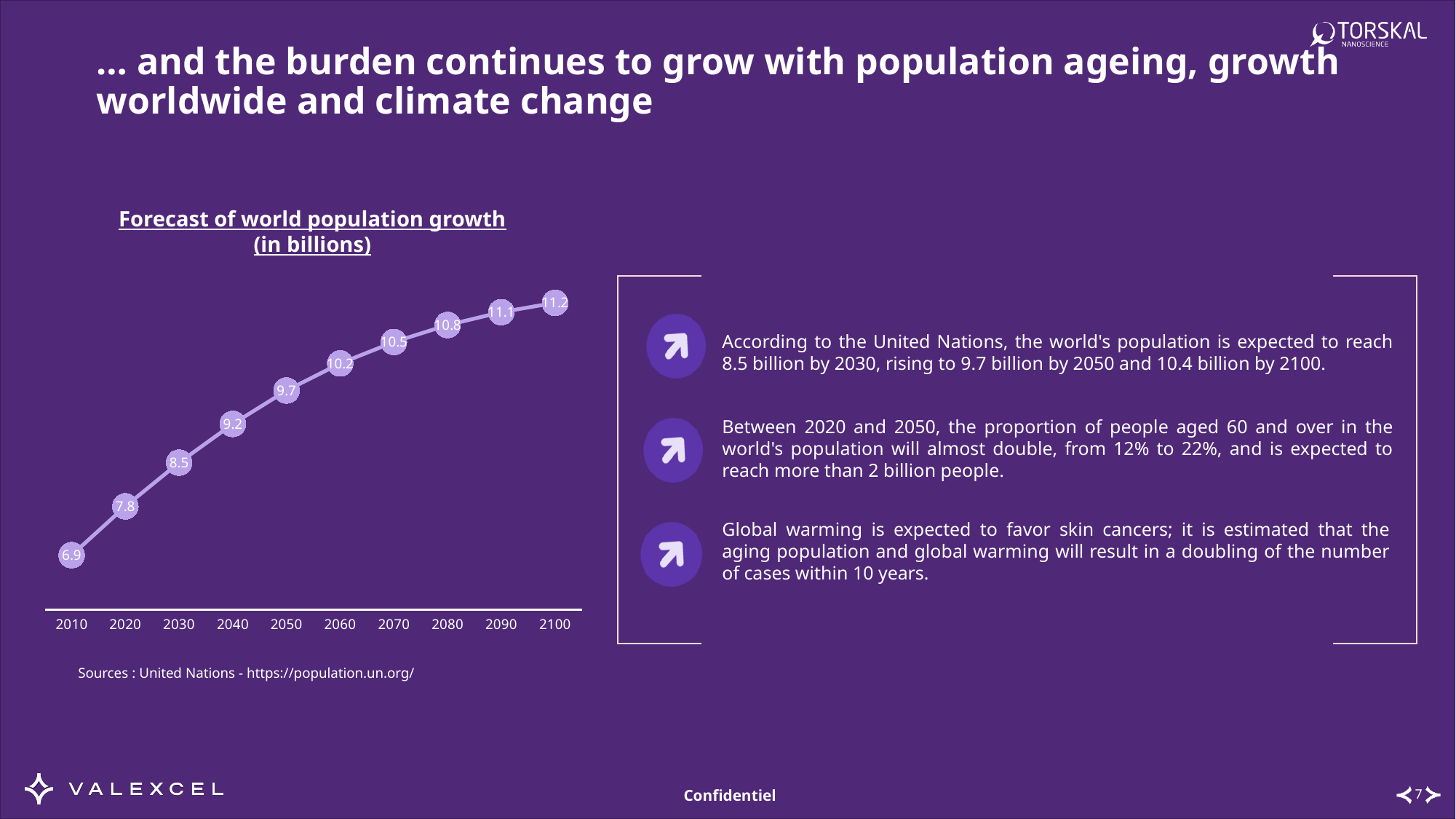
What is the difference between the forecast world population in 2050 and in 2020? 1.9 What is the forecast world population for 2100 in the chart? 11.2 How many data points are plotted in the chart? 10 Do the values in the chart rise or fall from 2010 to 2100? Rise What is the difference between the forecast world population in 2100 and in 2010? 4.3 Which year has a larger forecast world population, 2040 or 2060? 2060 What is the forecast world population for 2010 in the chart? 6.9 What is the forecast world population for 2050 in the chart? 9.7 What kind of chart is shown on the slide? Line chart Which year has the highest forecast world population in the chart? 2100 What is the forecast world population for 2030 in the chart? 8.5 Which year has the lowest forecast world population in the chart? 2010